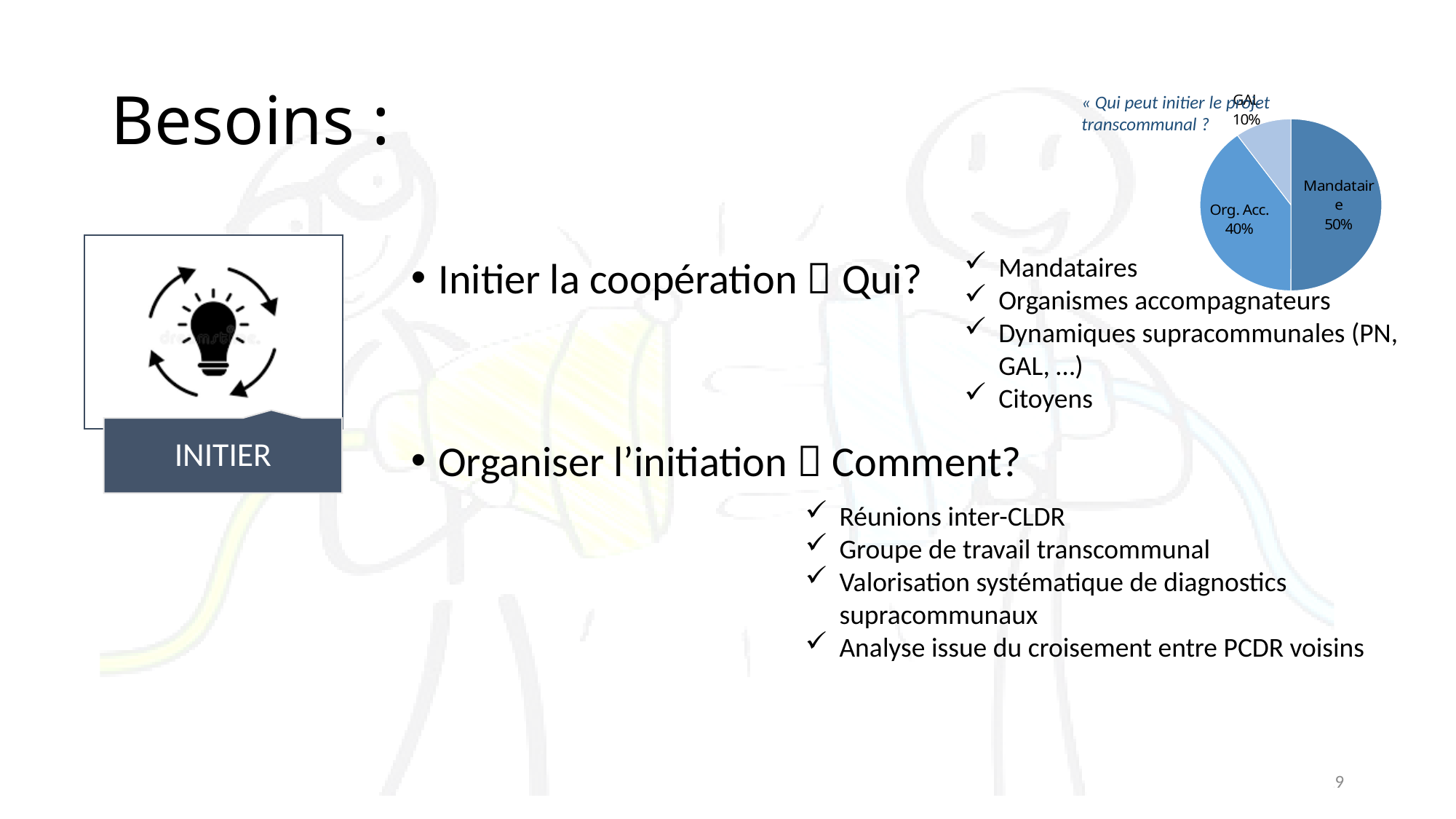
Where on the slide is the pie chart located? top right What question does the pie chart's title ask? « Qui peut initier le projet transcommunal ? » What share of the pie does Org. Acc. have? 40% What is the difference in percentage points between the Org. Acc. and GAL slices? 30 What share of the pie does GAL have? 10% Which slice of the pie chart is the largest? Mandataire Which slice of the pie chart is the smallest? GAL How many slices does the pie chart have? 3 What kind of chart is shown on the slide? pie chart Which is larger, the Org. Acc. slice or the GAL slice? Org. Acc. What share of the pie does Mandataire have? 50% What is the difference in percentage points between the Mandataire and Org. Acc. slices? 10